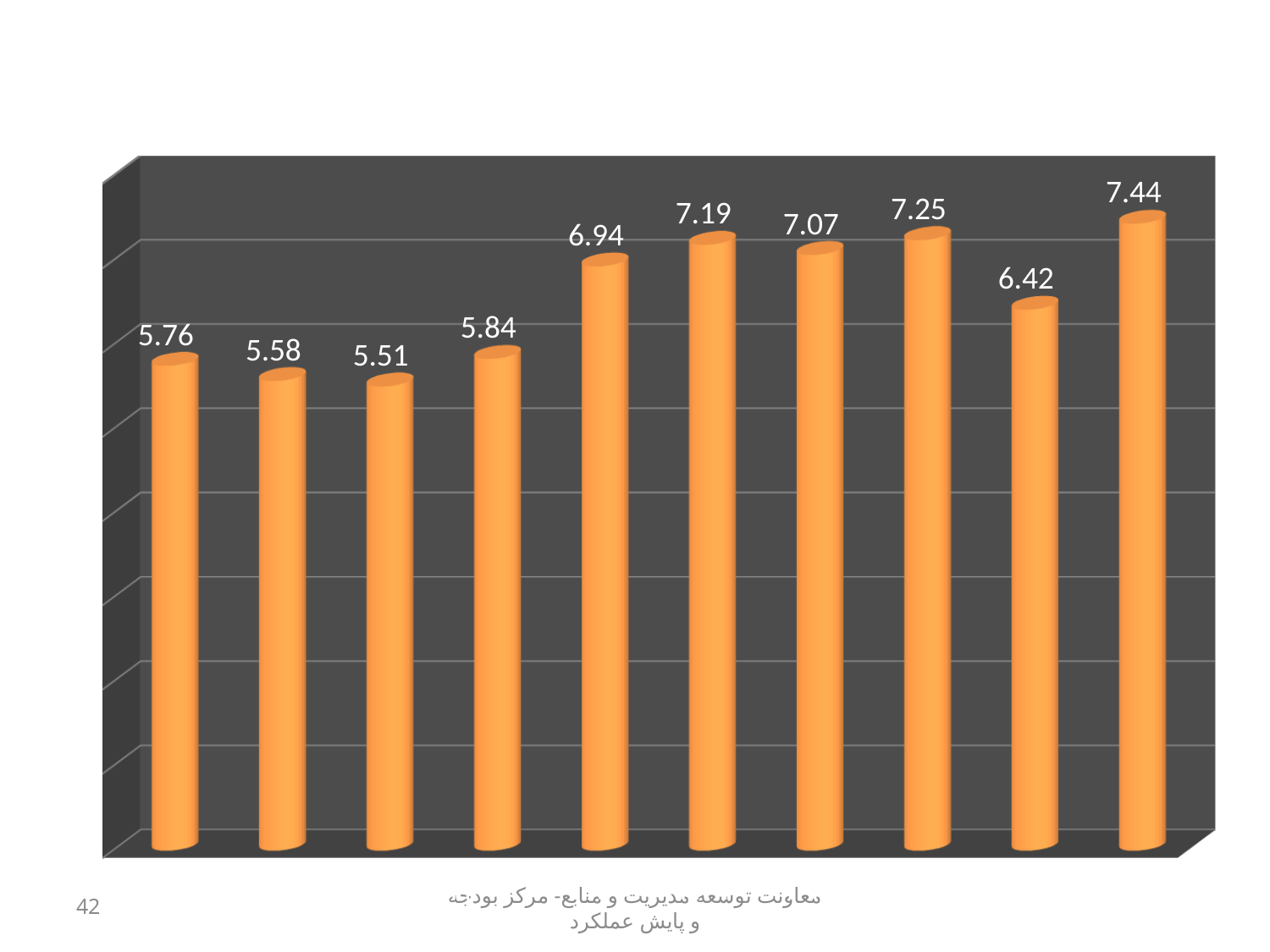
What is the highest value labelled on any bar in the chart? 7.44 What colour are the bars in the chart? orange What is the value shown on the third bar from the left? 5.51 What is the value shown on the rightmost bar? 7.44 How many bars are plotted in the chart? 10 What is the value shown on the ninth bar from the left? 6.42 What kind of chart is shown on the slide? bar chart What is the value shown on the first bar from the left? 5.76 What is the lowest value labelled on any bar in the chart? 5.51 What is the difference between the eighth bar's value (7.25) and the ninth bar's value (6.42)? 0.83 Which is larger: the value of the sixth bar from the left or the value of the seventh bar from the left? the sixth bar (7.19) What is the difference between the value of the rightmost bar (7.44) and the value of the leftmost bar (5.76)? 1.68